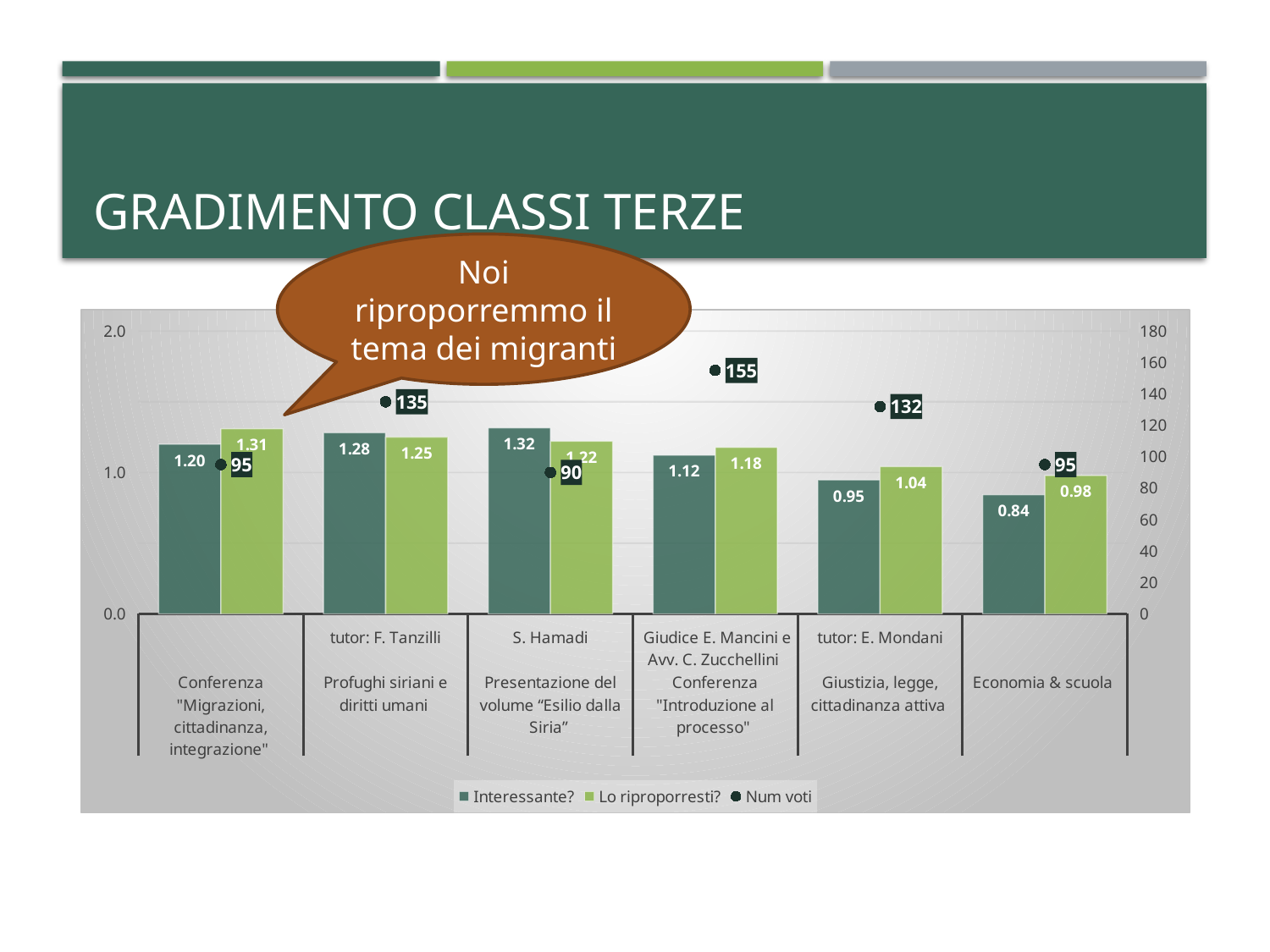
Which is larger for Profughi siriani e diritti umani: the "Interessante?" value or the "Lo riproporresti?" value? Interessante? How many series does the legend list? 3 Which category has the highest "Num voti" value? Conferenza "Introduzione al processo" What is the "Num voti" value for Conferenza "Introduzione al processo"? 155 Which category has the lowest "Lo riproporresti?" value? Economia & scuola How many categories are shown on the x axis? 6 What does the speech bubble on the slide say? Noi riproporremmo il tema dei migranti Which category has the highest "Interessante?" value? Presentazione del volume "Esilio dalla Siria" What is the "Num voti" value for Profughi siriani e diritti umani? 135 What is the difference between the "Lo riproporresti?" and "Interessante?" values for Conferenza "Migrazioni, cittadinanza, integrazione"? 0.11 What is the "Interessante?" value for Economia & scuola? 0.84 What is the "Lo riproporresti?" value for Giustizia, legge, cittadinanza attiva? 1.04